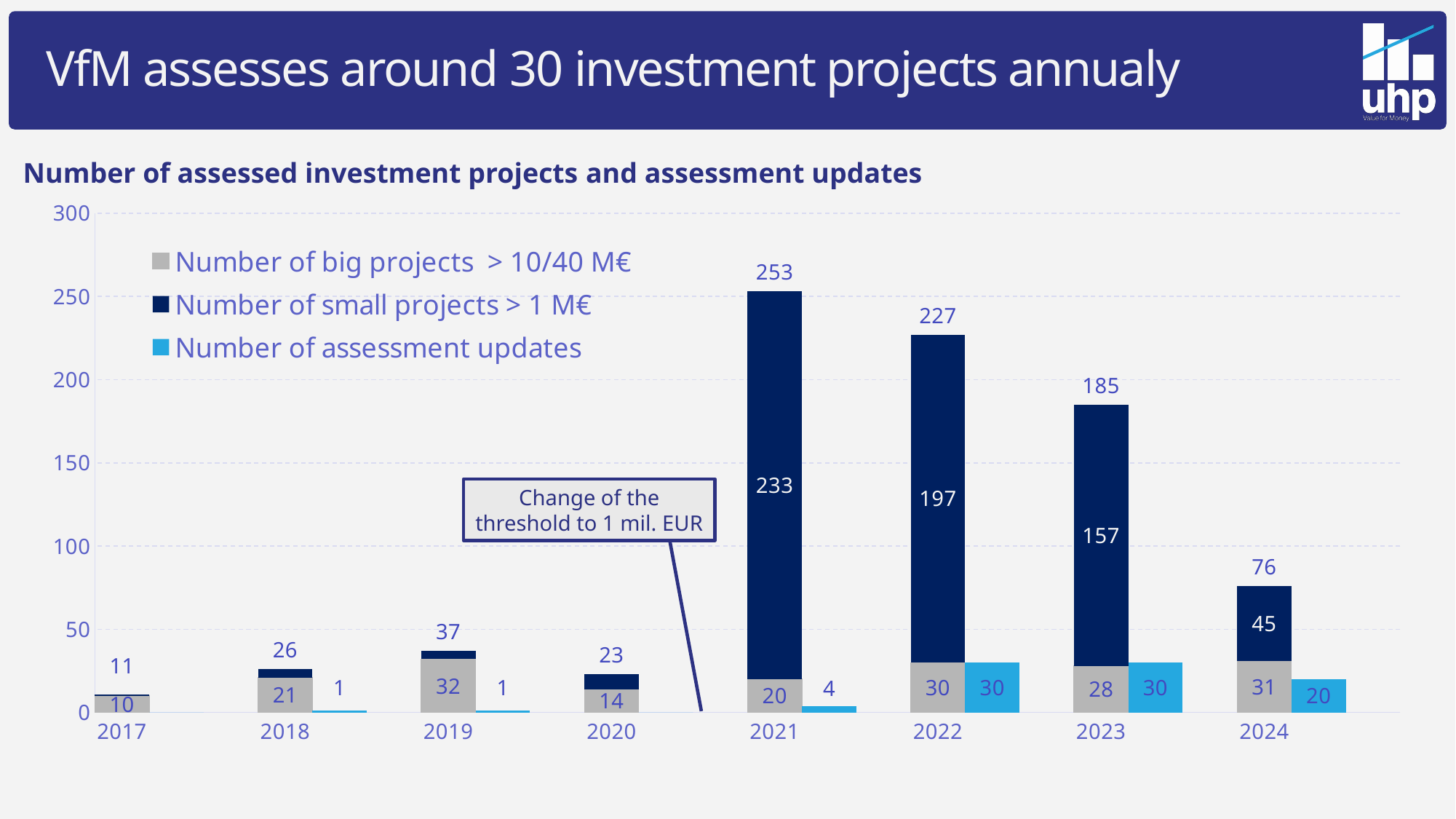
What is the number of big projects in 2019? 32 What kind of chart is shown on the slide? Bar chart What is the total number of assessed projects (big plus small) shown above the stacked bar for 2021? 253 Which year has the lowest total of assessed projects? 2017 How many series does the legend list? 3 What is the number of assessment updates in 2024? 20 Which is larger, the number of big projects in 2022 or in 2023? 2022 What is the difference between the number of small projects in 2021 and in 2023? 76 Is the total of assessed projects in 2023 greater or less than 150? greater Which year has the highest total of assessed projects? 2021 What is the number of small projects in 2022? 197 How many years are shown on the x axis? 8